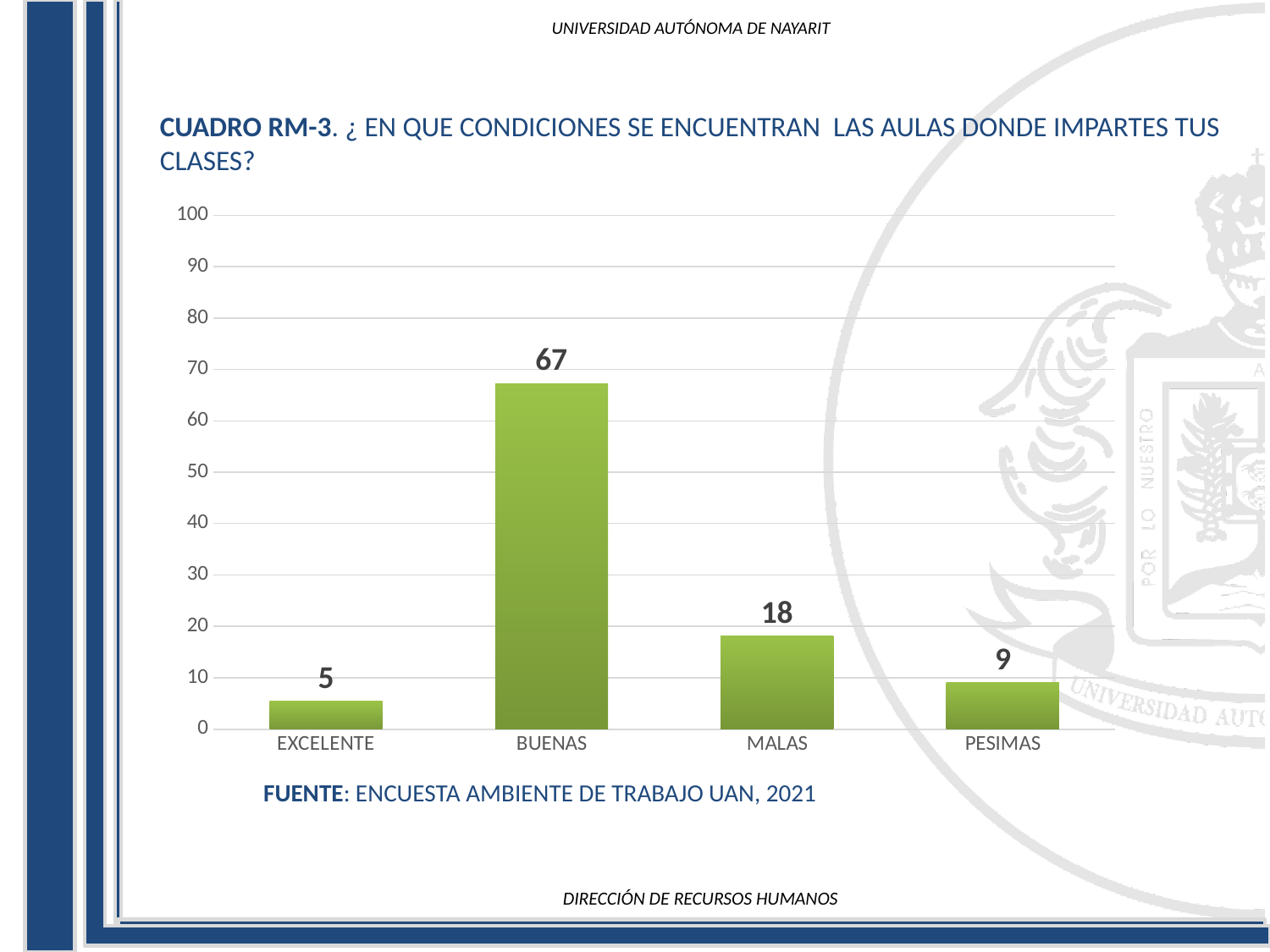
What is the difference between the values for PESIMAS and EXCELENTE? 4 Which is larger, the value for MALAS or the value for PESIMAS? MALAS What source is cited below the chart? ENCUESTA AMBIENTE DE TRABAJO UAN, 2021 What is the difference between the values for BUENAS and MALAS? 49 What is the value for PESIMAS? 9 Which category has the highest value? BUENAS Which category has the lowest value? EXCELENTE What is the value for BUENAS? 67 What kind of chart is shown on the slide? Bar chart What is the value for MALAS? 18 How many categories are shown on the x axis? 4 What is the value for EXCELENTE? 5